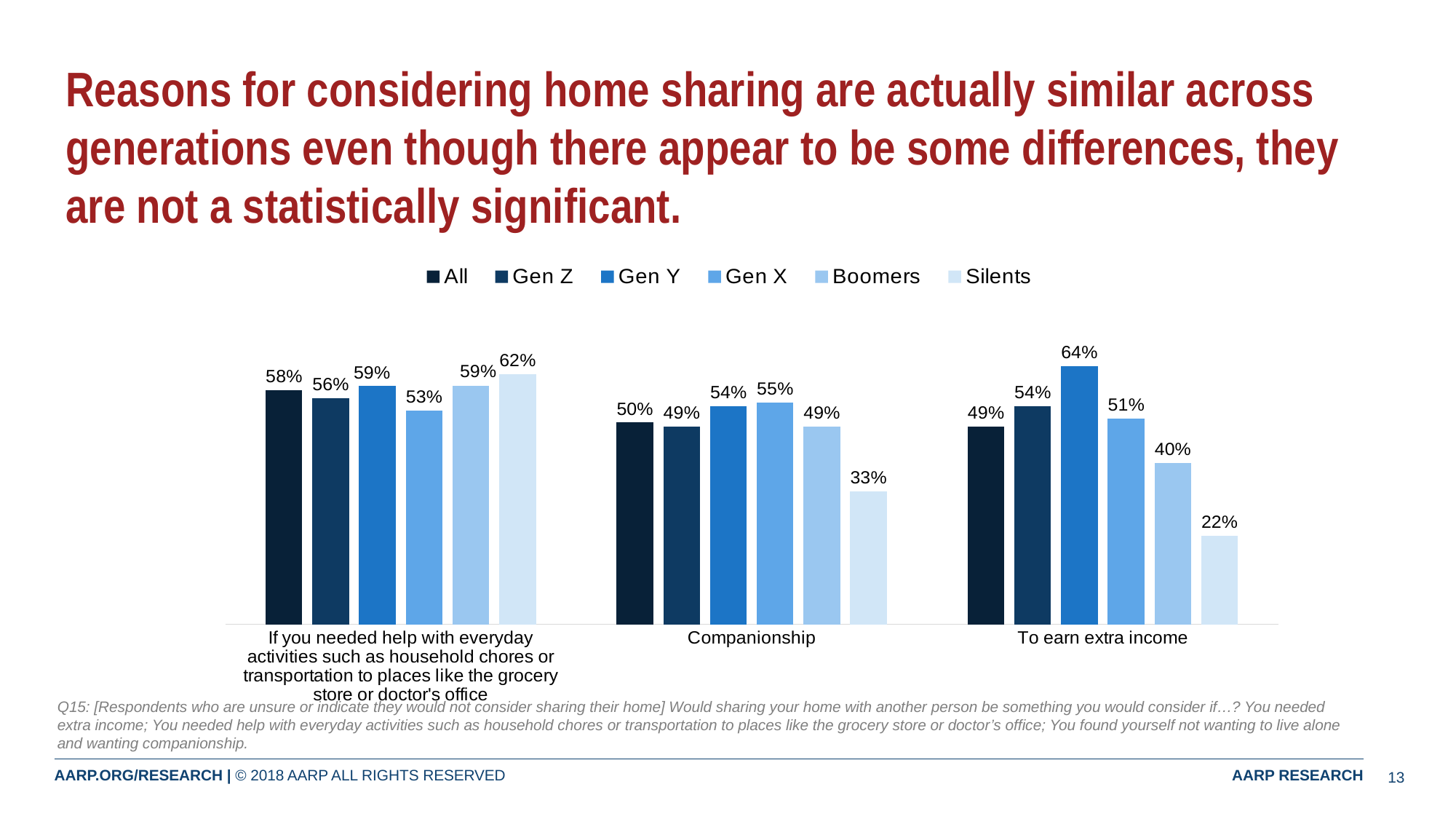
Which series has the lowest value in the "Companionship" category? Silents Which series has the highest value in the "If you needed help with everyday activities" category? Silents Which is larger in the "Companionship" category: the value for Gen X or the value for Boomers? Gen X What is the difference between the Gen Y and Silents values in the "To earn extra income" category? 42% How many series does the legend list? 6 What is the value for Silents in the "To earn extra income" category? 22% What is the difference between the Silents values for "If you needed help with everyday activities" and "Companionship"? 29% What is the value for Gen X in the "If you needed help with everyday activities" category? 53% What kind of chart is shown on the slide? Bar chart Which series has the highest value in the "To earn extra income" category? Gen Y How many categories are shown on the x axis? 3 What is the value for Gen Y in the "Companionship" category? 54%